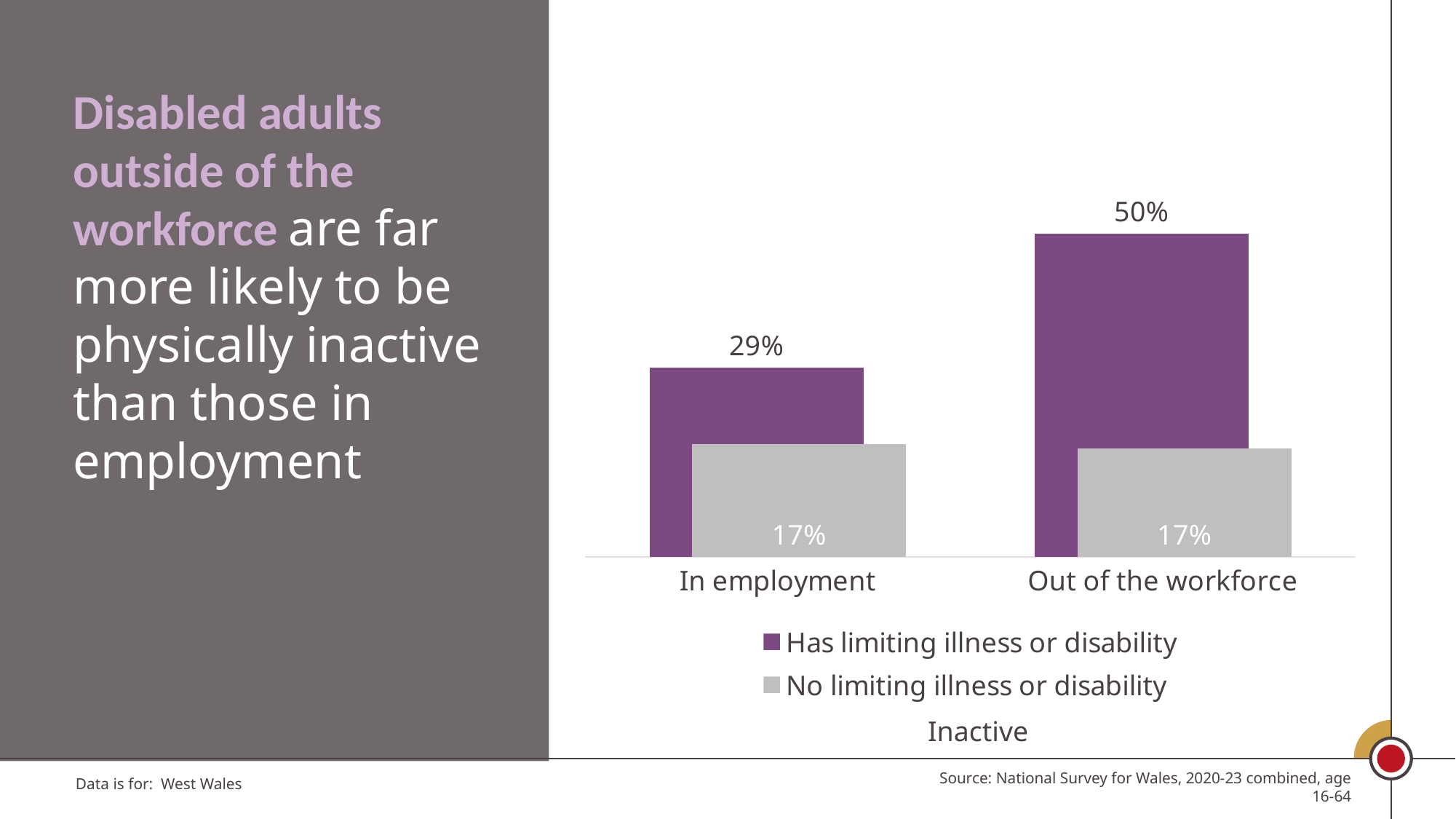
What is the inactive percentage for people out of the workforce with no limiting illness or disability? 17% For people out of the workforce, what is the difference in inactive percentage between those with and without a limiting illness or disability? 33 percentage points Which is larger: the inactive percentage for those with a limiting illness or disability in employment, or for those with no limiting illness or disability in employment? Has limiting illness or disability What kind of chart is shown on the slide? Bar chart What percentage of people out of the workforce with a limiting illness or disability are inactive? 50% What colour are the bars for the 'Has limiting illness or disability' series? Purple Which category has the highest inactive percentage for those with a limiting illness or disability? Out of the workforce What is the difference between the inactive percentages for those with a limiting illness or disability out of the workforce and in employment? 21 percentage points How many categories are shown on the x axis of the chart? 2 How many series does the chart legend list? 2 What percentage of people in employment with a limiting illness or disability are inactive? 29% What is the inactive percentage for people in employment with no limiting illness or disability? 17%